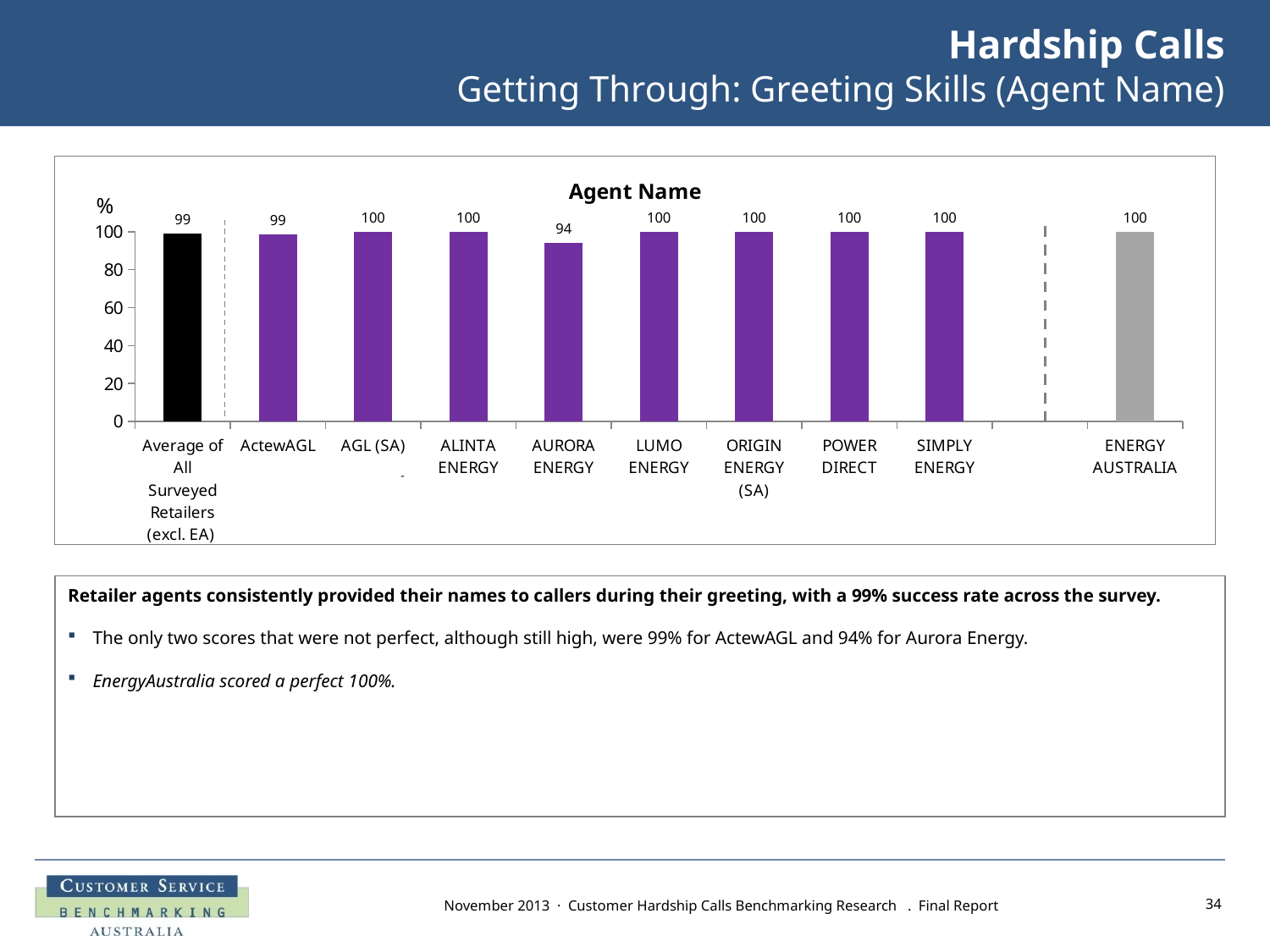
Is the value for AURORA ENERGY greater or less than 80? greater Which category has the lowest value? AURORA ENERGY What kind of chart is shown? bar chart What is the difference between the values for AGL (SA) and AURORA ENERGY? 6 What is the value for AURORA ENERGY? 94 What is the title of the chart? Agent Name What is the value for Average of All Surveyed Retailers (excl. EA)? 99 How many categories are shown on the x axis? 10 What is the value for ActewAGL? 99 What is the difference between the values for ActewAGL and AURORA ENERGY? 5 Which is larger, the value for ActewAGL or the value for AURORA ENERGY? ActewAGL What is the value for ENERGY AUSTRALIA? 100